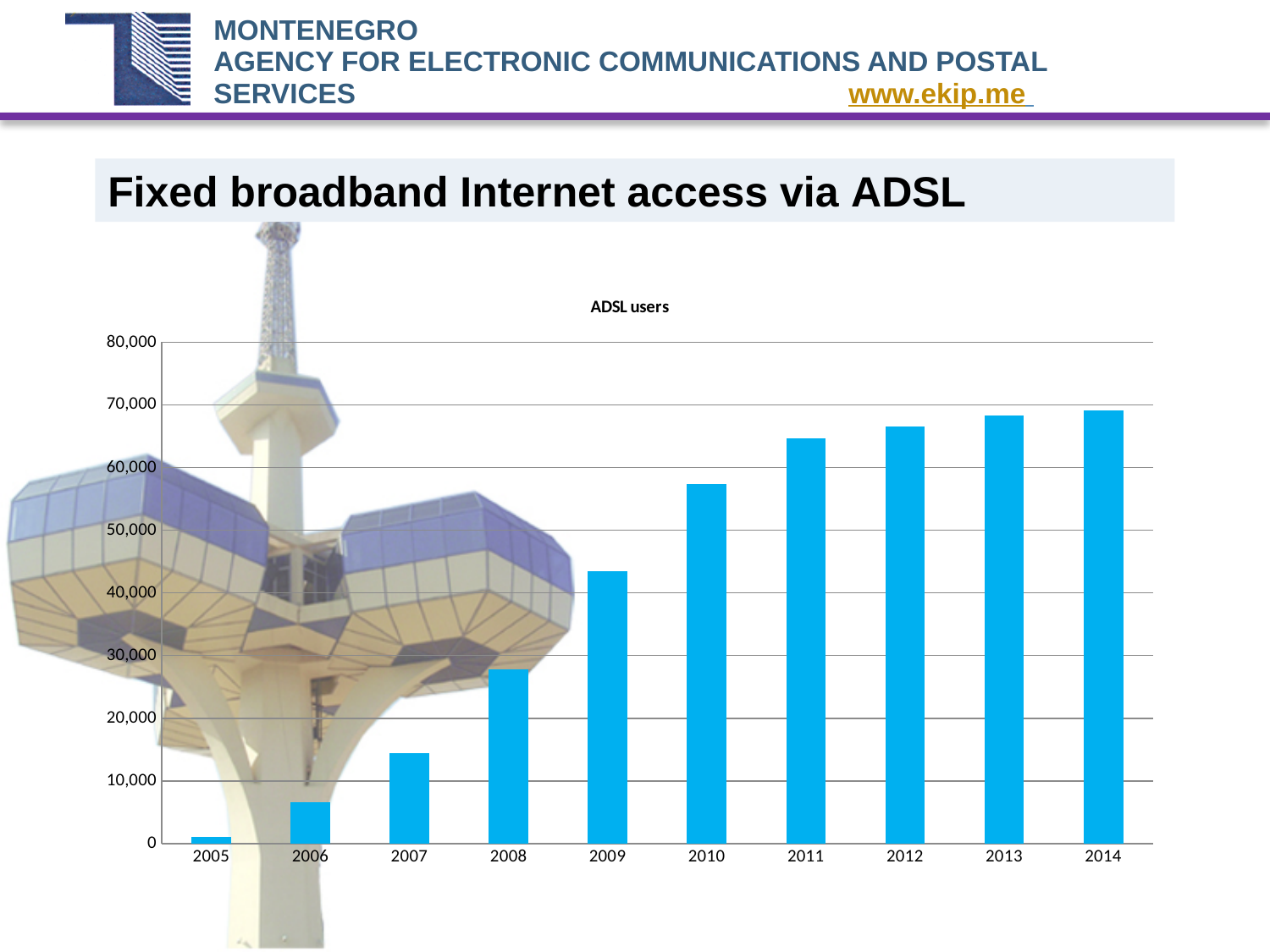
Is the value for 2009 greater or less than 40,000? greater What is the title of the chart? ADSL users Is the value for 2010 greater or less than 50,000? greater Is the value for 2006 greater or less than 10,000? less Do the values rise or fall from 2005 to 2014? rise What kind of chart is shown on the slide? bar chart Which year has more ADSL users, 2010 or 2012? 2012 Which year has more ADSL users, 2008 or 2009? 2009 Which year has the lowest number of ADSL users? 2005 How many years are shown on the x axis of the chart? 10